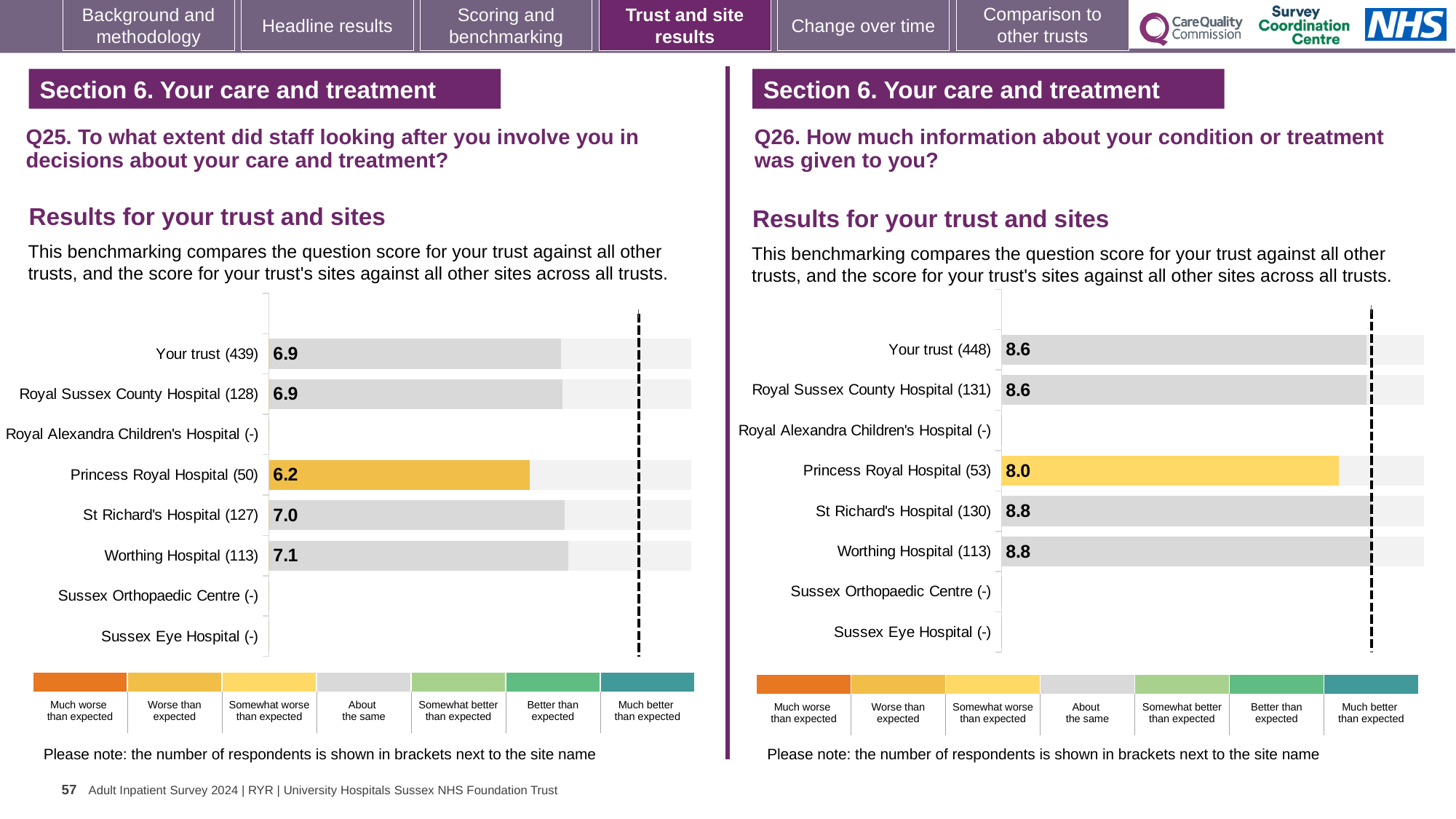
What kind of chart is used on the Q25 chart (left)? Bar chart On the Q25 chart (left), what is the score for Princess Royal Hospital (50)? 6.2 On the Q26 chart (right), what is the difference between the scores for St Richard's Hospital and Your trust? 0.2 On the Q25 chart (left), how many sites are listed on the vertical axis, including Your trust? 8 On the Q26 chart (right), which site has the lowest score? Princess Royal Hospital (53) On the Q26 chart (right), which is larger: the score for St Richard's Hospital or the score for Royal Sussex County Hospital? St Richard's Hospital On the Q25 chart (left), what is the difference between the scores for Worthing Hospital and Princess Royal Hospital? 0.9 On the Q26 chart (right), what is the score for Your trust (448)? 8.6 On the Q25 chart (left), what is the score for Your trust (439)? 6.9 On the Q26 chart (right), what is the score for Princess Royal Hospital (53)? 8.0 On the Q25 chart (left), which site has the lowest score? Princess Royal Hospital (50) On the Q25 chart (left), which site has the highest score? Worthing Hospital (113)